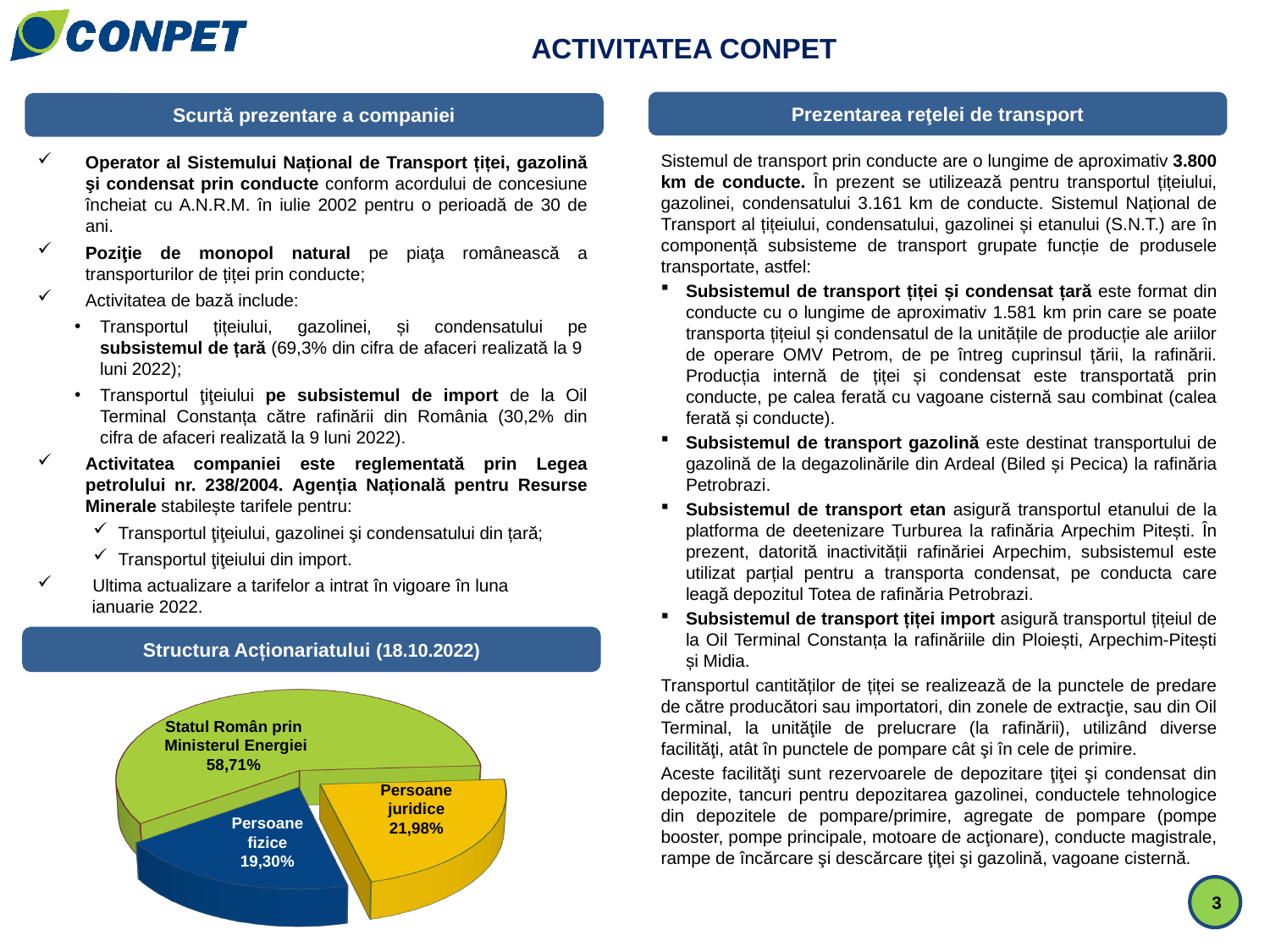
What share of the shareholding structure is held by Statul Român prin Ministerul Energiei? 58,71% What share of the shareholding structure is held by Persoane fizice? 19,30% What share of the shareholding structure is held by Persoane juridice? 21,98% Which is larger in the pie chart: the share of Persoane juridice or the share of Persoane fizice? Persoane juridice What date is given in the title of the shareholding structure chart? 18.10.2022 What colour is the slice representing Persoane fizice in the pie chart? Blue What kind of chart is used to show the Structura Acționariatului? Pie chart What is the difference in percentage points between the share of Statul Român prin Ministerul Energiei and the share of Persoane juridice? 36,73 How many slices does the Structura Acționariatului pie chart have? 3 Which category holds the largest share in the Structura Acționariatului pie chart? Statul Român prin Ministerul Energiei What is the difference in percentage points between the share of Persoane juridice and the share of Persoane fizice? 2,68 Which category holds the smallest share in the Structura Acționariatului pie chart? Persoane fizice